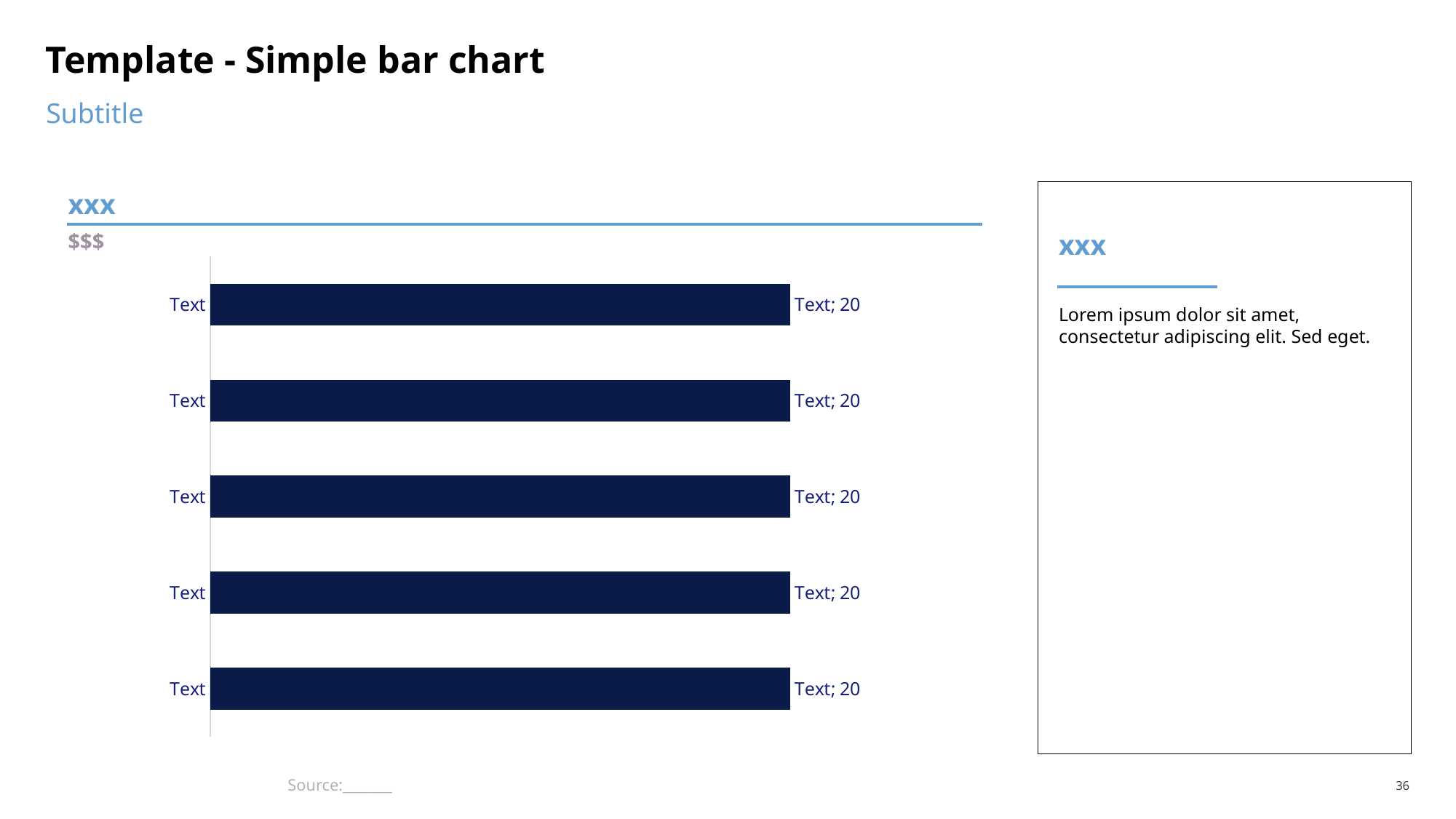
How many bars does the chart contain? 5 What value is printed on the data label of the top bar? 20 Are the bars in the chart horizontal or vertical? horizontal What kind of chart is shown on the slide? bar chart What is the difference between the value of the top bar and the value of the bottom bar? 0 What is the title shown above the chart? xxx What value is printed on the data label of the middle (third) bar? 20 What unit label is shown below the chart title? $$$ What value is printed on the data label of the bottom bar? 20 What category label is shown next to each bar? Text Do all the bars in the chart have the same value? Yes